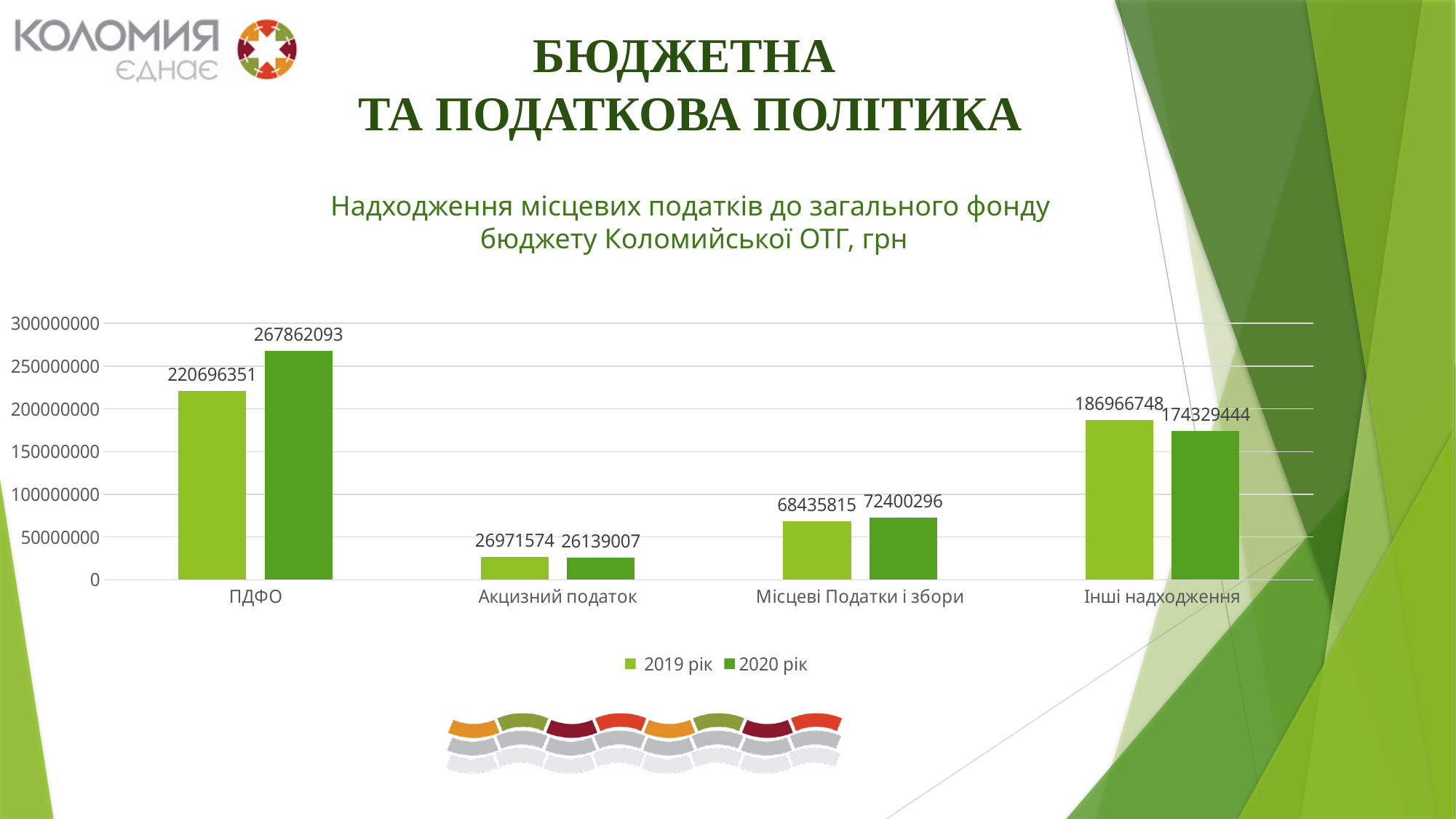
For Інші надходження, which series has the larger value, 2019 рік or 2020 рік? 2019 рік How many categories are shown on the x axis? 4 What is the value for ПДФО in the 2019 рік series? 220696351 What is the difference between the 2019 рік and 2020 рік values for Інші надходження? 12637304 Which category has the lowest value in the 2019 рік series? Акцизний податок What is the value for Місцеві Податки і збори in the 2020 рік series? 72400296 What is the difference between the 2020 рік and 2019 рік values for ПДФО? 47165742 What is the value for Інші надходження in the 2019 рік series? 186966748 Which category has the highest value in the 2020 рік series? ПДФО What is the value for ПДФО in the 2020 рік series? 267862093 How many series does the legend list? 2 What kind of chart is shown on the slide? Bar chart